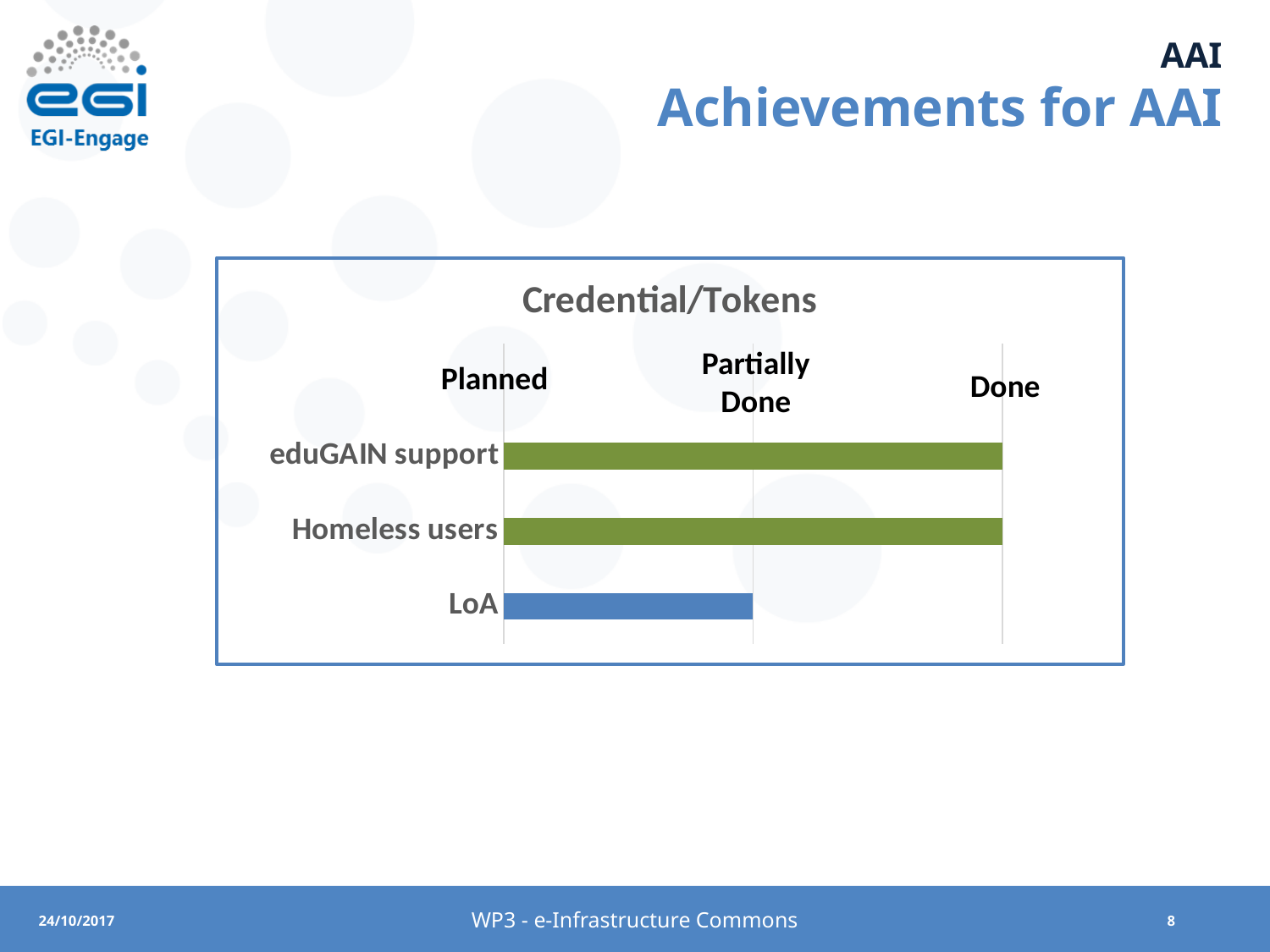
Which category has the shortest bar? LoA Which bar is longer, the one for eduGAIN support or the one for LoA? eduGAIN support Which status does the bar for eduGAIN support reach on the axis? Done What colour is the bar for LoA? blue Which status does the bar for Homeless users reach on the axis? Done Which status does the bar for LoA reach on the axis? Partially Done What are the three status labels shown along the axis of the chart? Planned, Partially Done, Done What kind of chart is shown on the slide? bar chart Which bar is longer, the one for Homeless users or the one for LoA? Homeless users How many categories have bars that reach the Done mark? 2 What is the title of the chart? Credential/Tokens How many categories are plotted in the chart? 3